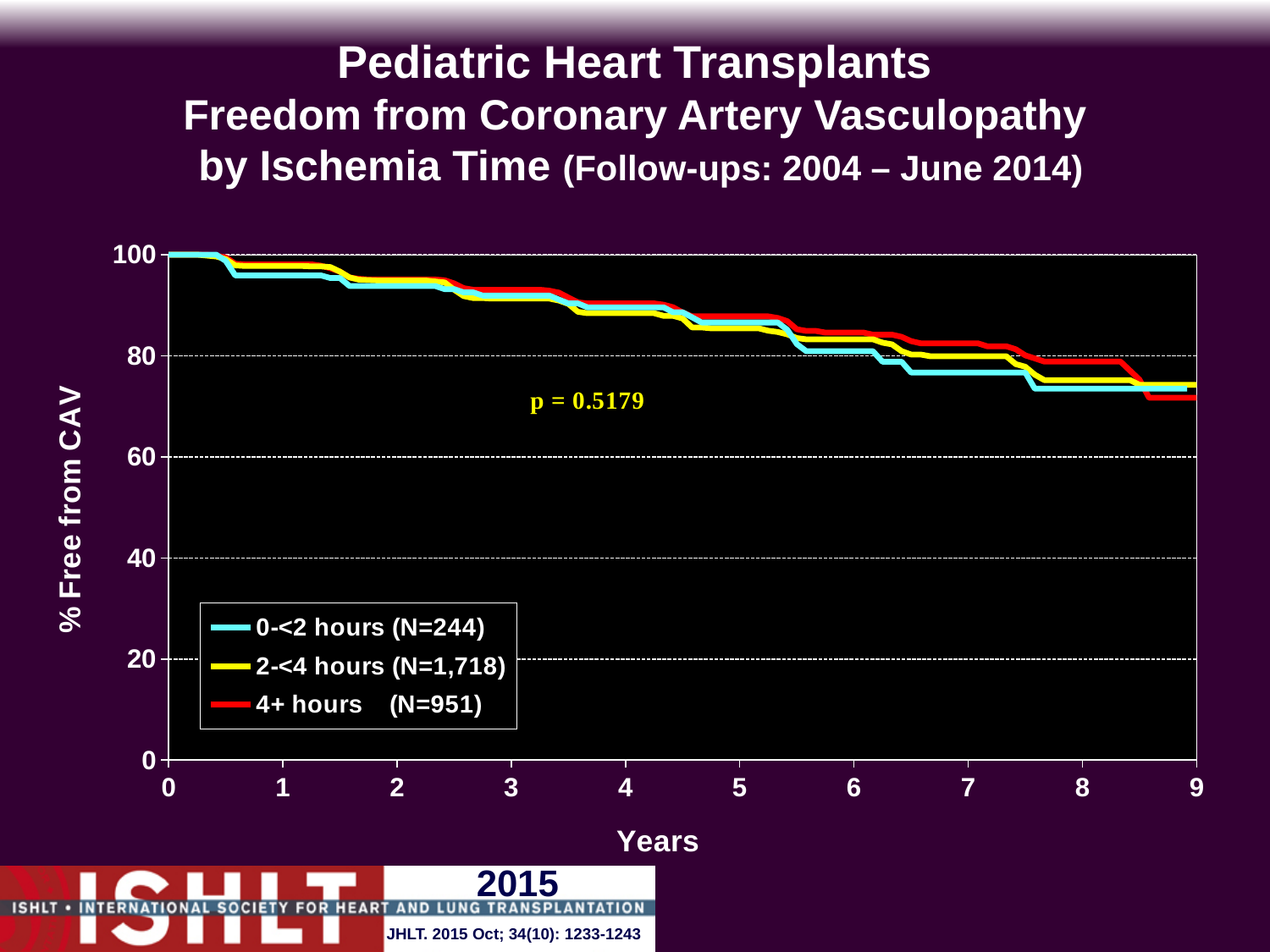
What is the label of the y axis? % Free from CAV How many series does the legend list? 3 At year 5, is the value for the 0-<2 hours group greater or less than 80? greater At year 7, which group has the higher % free from CAV, 4+ hours or 0-<2 hours? 4+ hours At year 1, is the value for the 4+ hours group greater or less than 80? greater At year 9, is the value for the 4+ hours group greater or less than 80? less Do the curves rise or fall as the years increase along the x axis? fall What is the p-value printed on the chart? p = 0.5179 What is the sample size (N) shown in the legend for the 2-<4 hours group? N=1,718 What kind of chart is shown on the slide? line chart